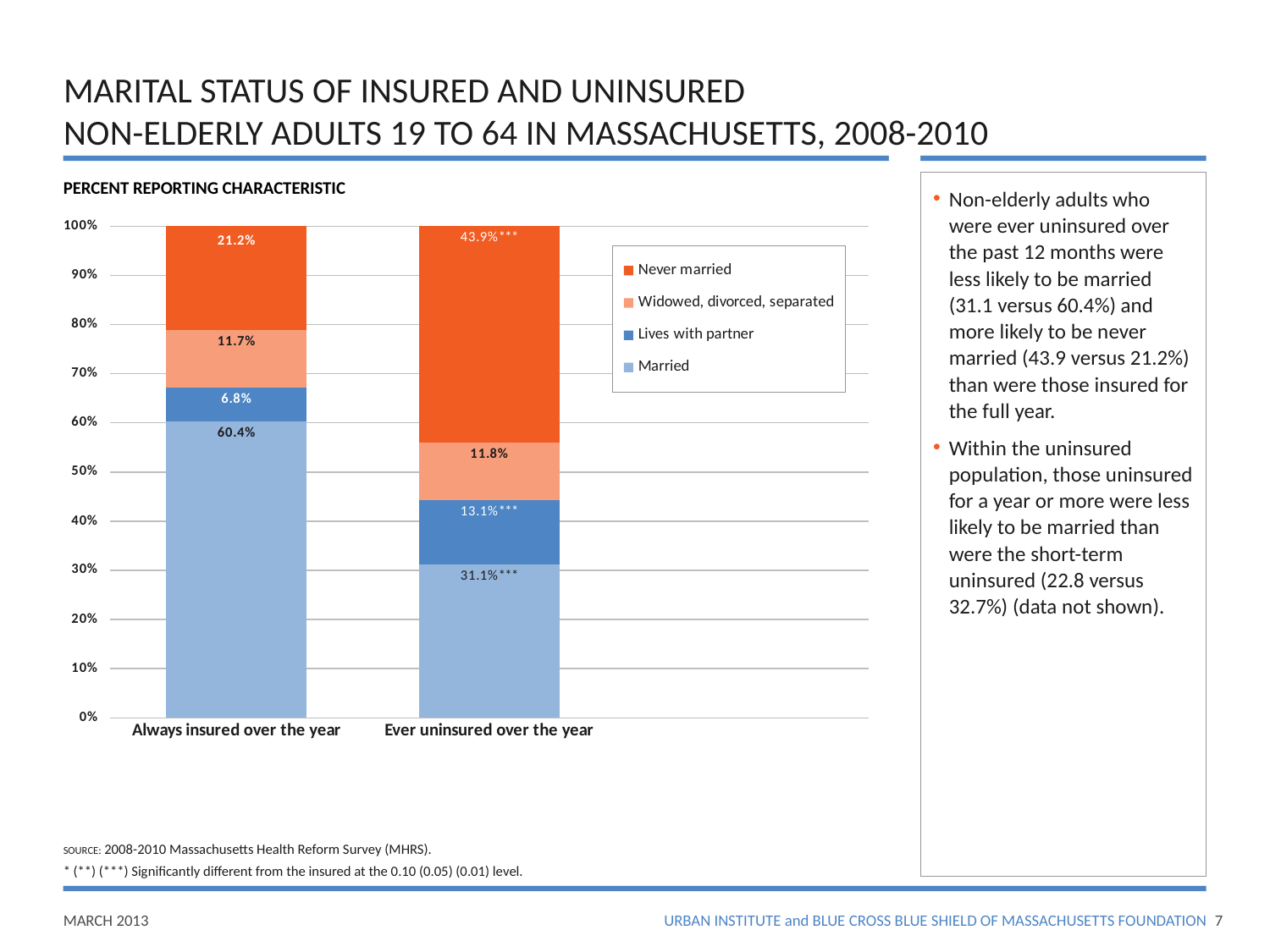
Which marital status segment is the smallest in the 'Always insured over the year' bar? Lives with partner What is the value for 'Lives with partner' in the 'Ever uninsured over the year' bar? 13.1% What is the value for 'Widowed, divorced, separated' in the 'Always insured over the year' bar? 11.7% What percentage of adults always insured over the year were married? 60.4% What type of chart is shown on the slide? Stacked bar chart Which marital status segment is the largest in the 'Always insured over the year' bar? Married How many series does the legend list? 4 How many percentage points higher is the married share for the always insured than for the ever uninsured? 29.3 percentage points What percentage of adults ever uninsured over the year were never married? 43.9% Which group has a larger 'Never married' share: always insured or ever uninsured over the year? Ever uninsured over the year Which marital status segment is the largest in the 'Ever uninsured over the year' bar? Never married How many categories are shown on the x axis? 2